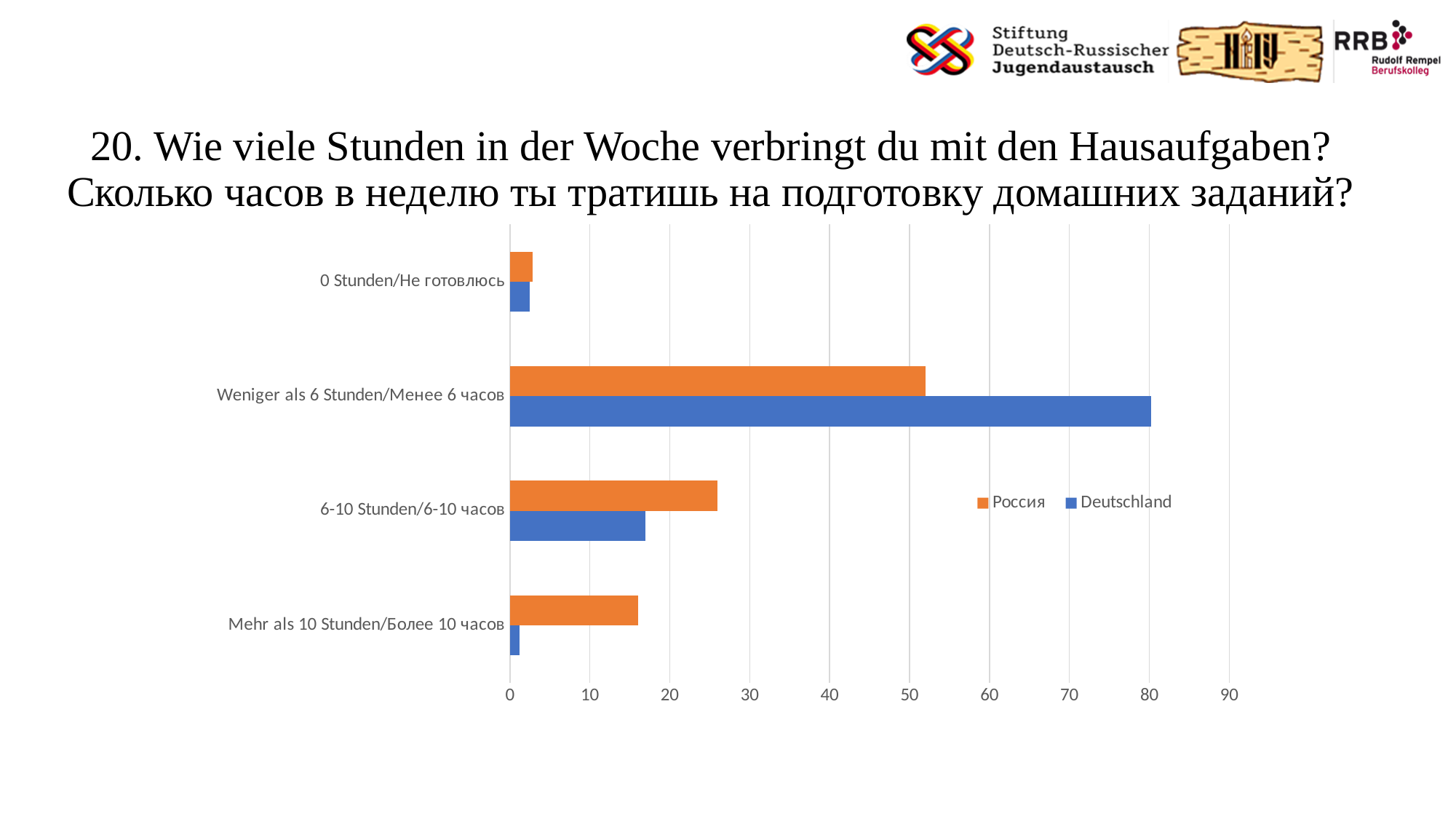
How many series does the legend list? 2 For the Deutschland series, which category has the highest value? Weniger als 6 Stunden/Менее 6 часов For the Deutschland series, which category has the lowest value? Mehr als 10 Stunden/Более 10 часов For the Россия series, which category has the lowest value? 0 Stunden/Не готовлюсь In the category Weniger als 6 Stunden/Менее 6 часов, which series has the larger value, Россия or Deutschland? Deutschland In the category 6-10 Stunden/6-10 часов, which series has the larger value, Россия or Deutschland? Россия Is the Deutschland value for 6-10 Stunden/6-10 часов greater or less than 20? less For the Россия series, which category has the highest value? Weniger als 6 Stunden/Менее 6 часов Is the Россия value for Weniger als 6 Stunden/Менее 6 часов greater or less than 50? greater How many categories are shown on the chart? 4 Which colour represents the Россия series in the legend? orange What kind of chart is shown on the slide? bar chart